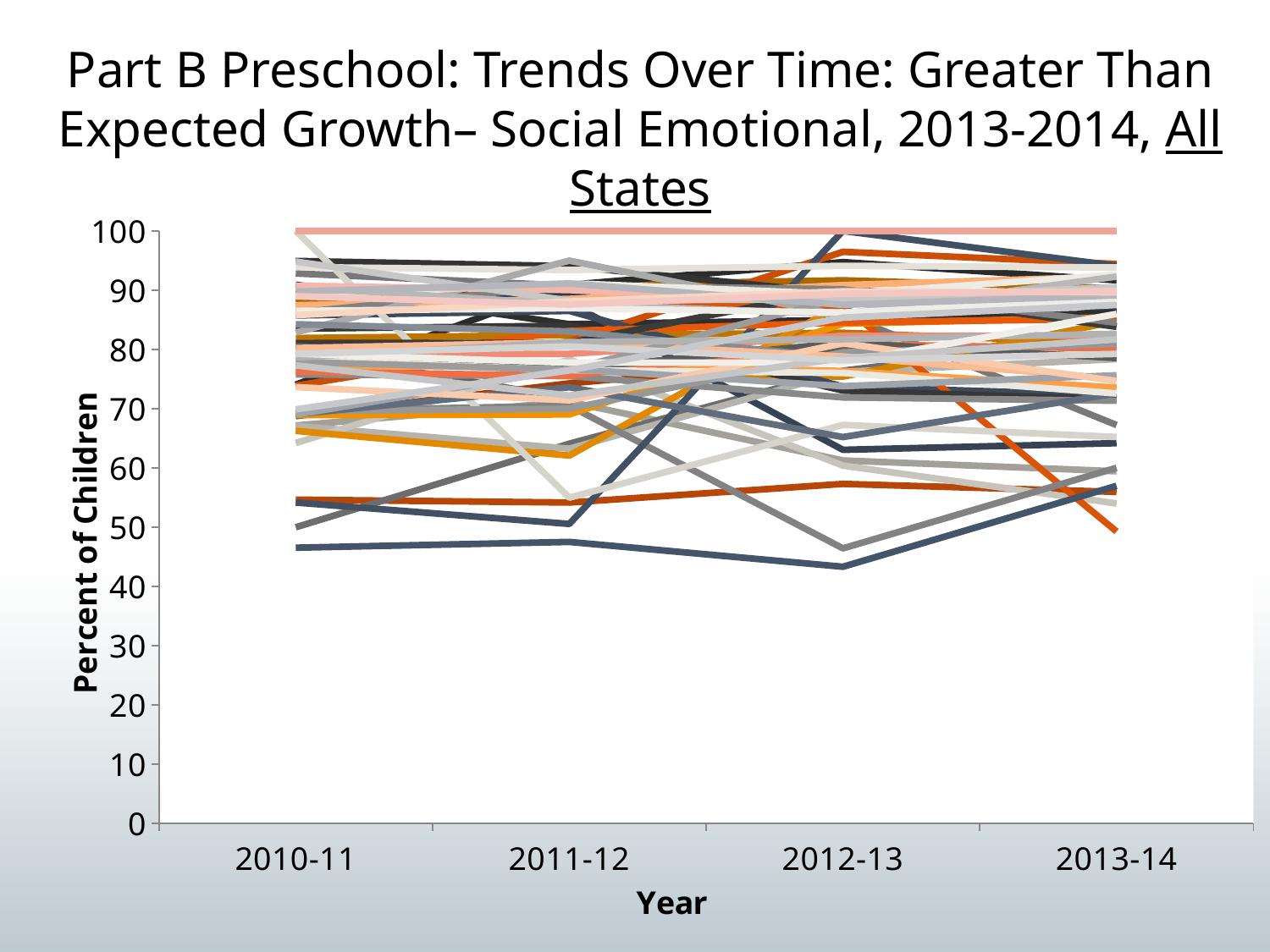
What is the maximum value shown on the y axis? 100 What is the highest value plotted for 2010-11? 100 What is the title of the x axis? Year Is the lowest value plotted for 2010-11 greater or less than 50? less Is the lowest value plotted for 2013-14 greater or less than 60? less What is the first year shown on the x axis? 2010-11 What kind of chart is shown on the slide? line chart Is the lowest value plotted for 2011-12 greater or less than 60? less What is the title of the y axis? Percent of Children What is the highest value plotted for 2013-14? 100 How many years are shown along the x axis of the chart? 4